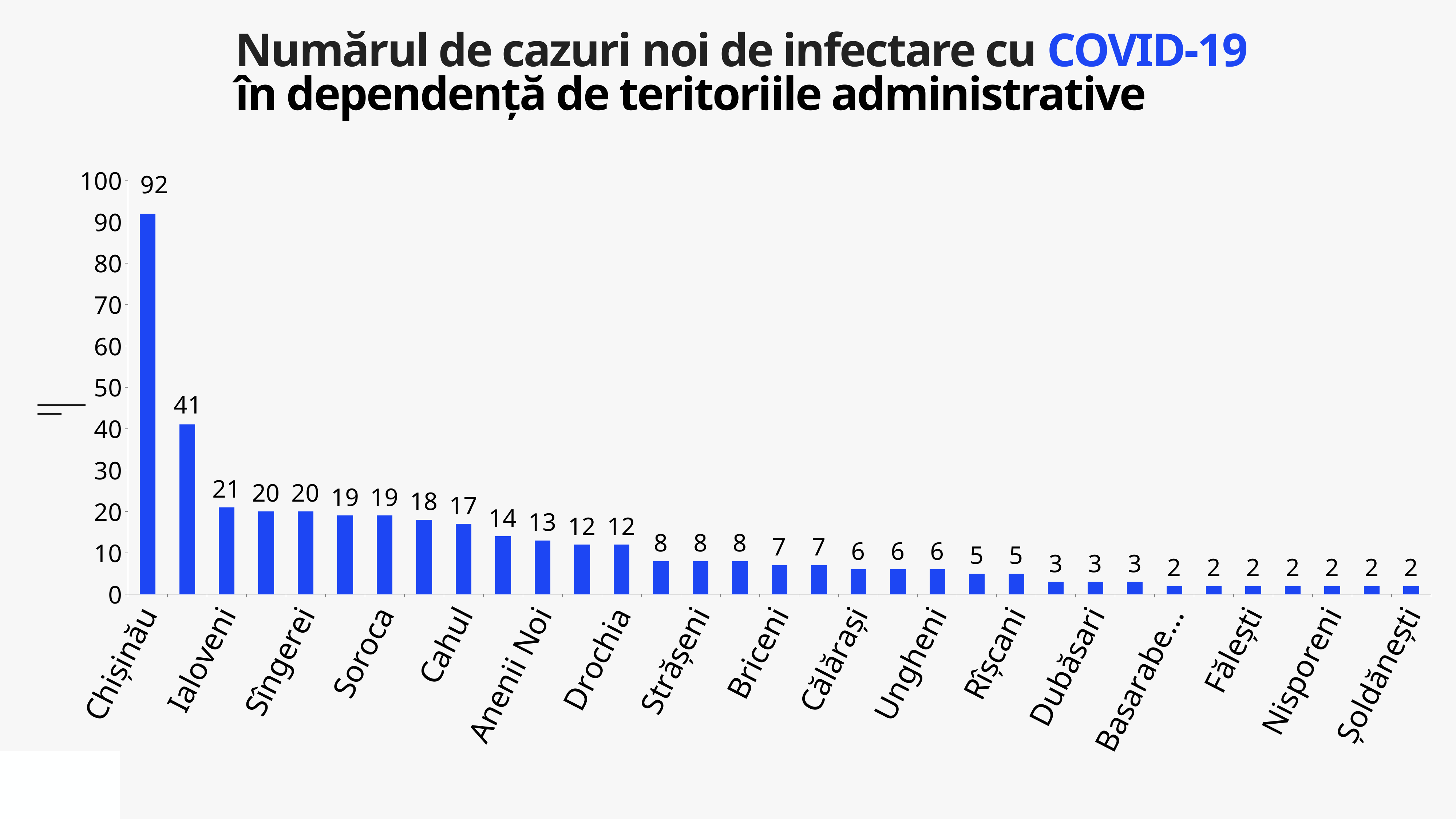
How many bars are plotted in the chart? 33 What is the value for Chișinău? 92 Which territory has the highest number of new cases? Chișinău What is the lowest value shown on any bar? 2 What is the value of the second-tallest bar? 41 Is the value for Chișinău greater or less than 50? greater Which is larger, the value for Chișinău or the value for Șoldănești? Chișinău Do the values rise or fall from left to right along the x axis? fall What is the difference between the tallest bar (92) and the second-tallest bar (41)? 51 What type of chart is shown on the slide? bar chart What is the value for Șoldănești, the last bar on the right? 2 What is the maximum value shown on the vertical axis? 100